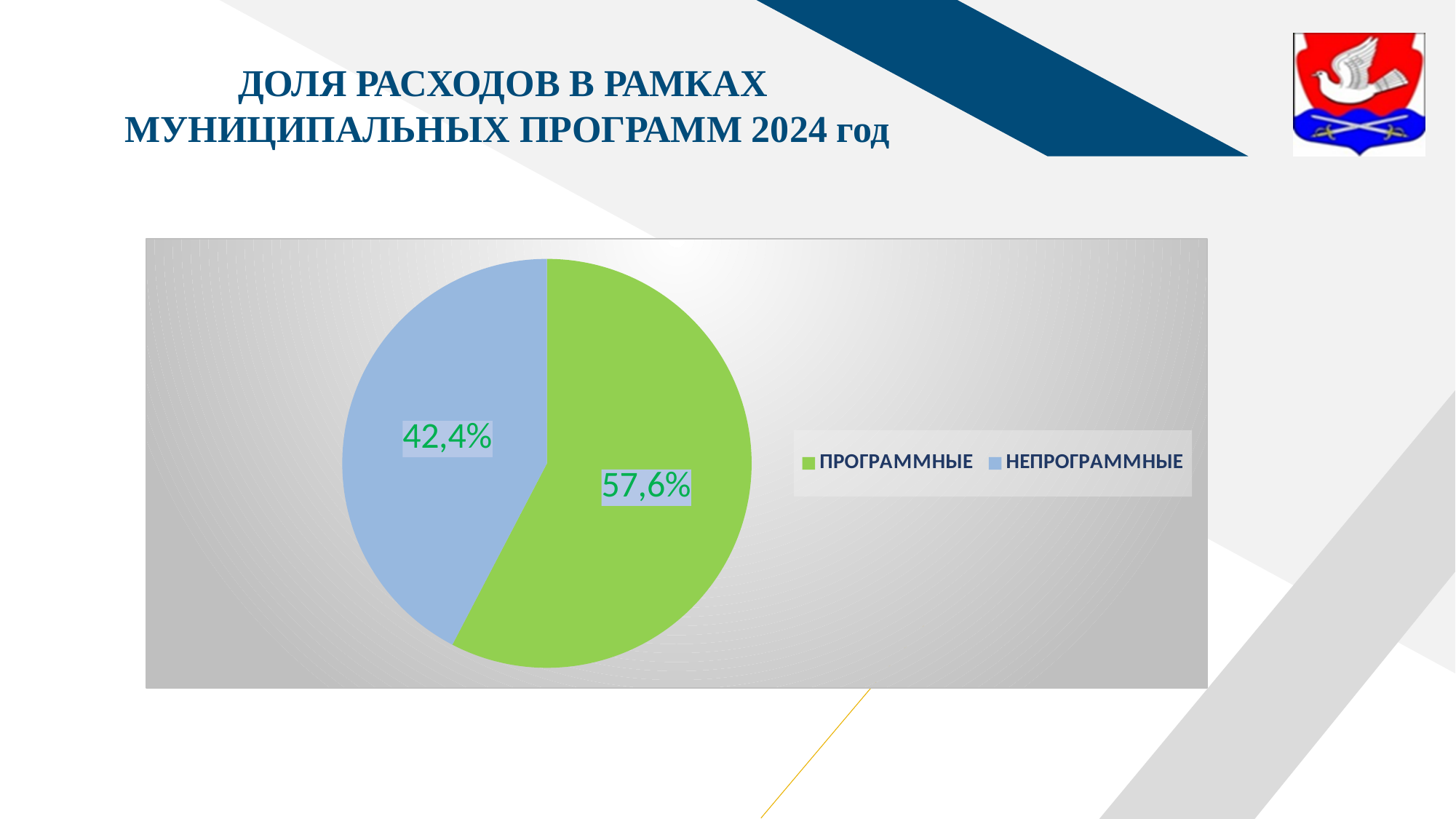
What share of the pie is labelled НЕПРОГРАММНЫЕ? 42,4% Which is larger, the ПРОГРАММНЫЕ slice or the НЕПРОГРАММНЫЕ slice? ПРОГРАММНЫЕ What colour is the ПРОГРАММНЫЕ slice? green What is the difference in percentage points between the ПРОГРАММНЫЕ and НЕПРОГРАММНЫЕ slices? 15,2% What kind of chart is shown on the slide? pie chart How many slices does the pie chart have? 2 Which slice of the pie is the largest? ПРОГРАММНЫЕ What colour is the НЕПРОГРАММНЫЕ slice? light blue What share of the pie is labelled ПРОГРАММНЫЕ? 57,6% Which slice of the pie is the smallest? НЕПРОГРАММНЫЕ How many entries does the legend list? 2